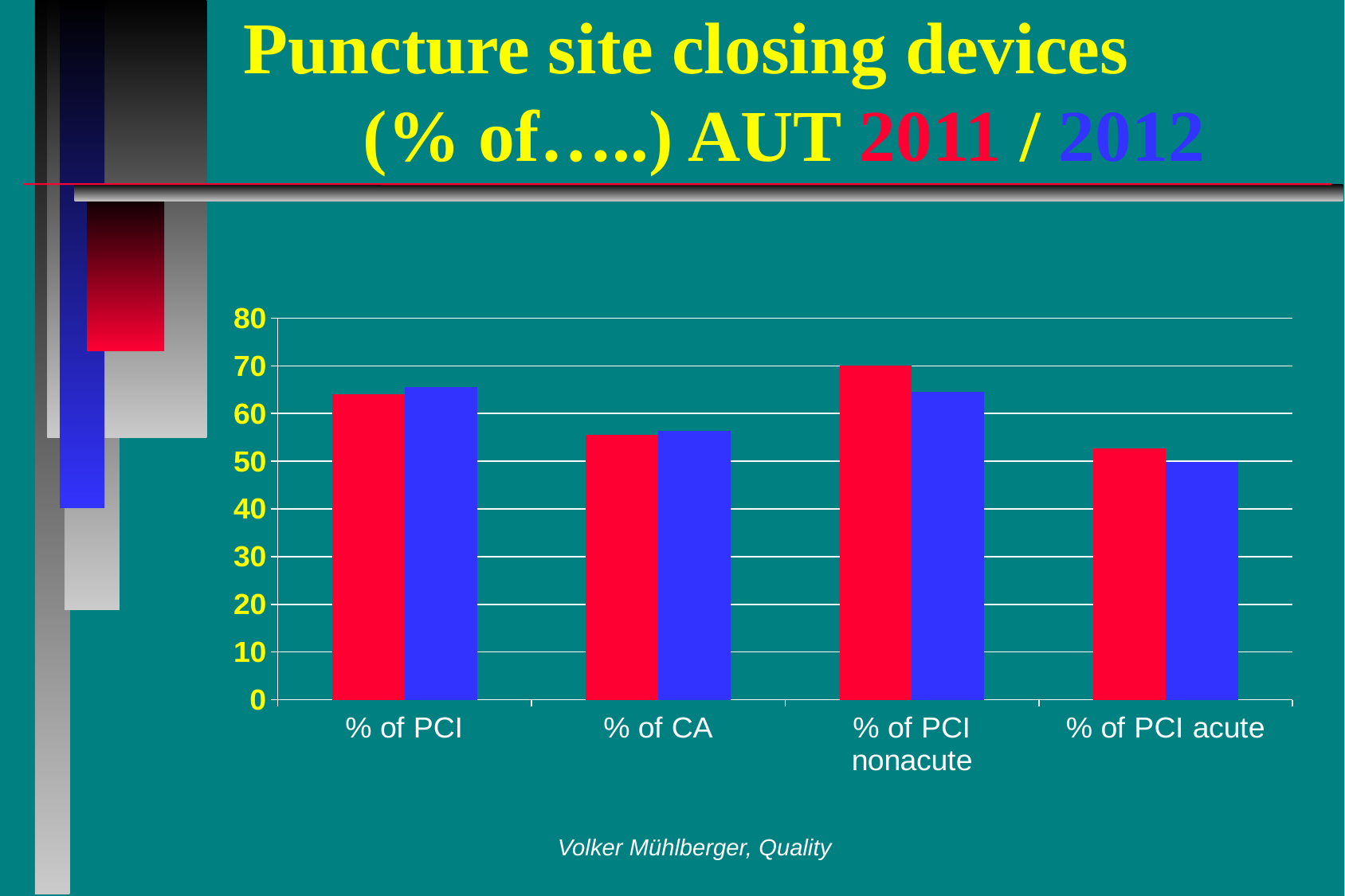
For % of PCI nonacute, which year has the larger value, 2011 or 2012? 2011 How many categories are shown on the x axis of the chart? 4 Which category has the lowest blue (2012) bar? % of PCI acute Is the 2012 value for % of PCI nonacute greater or less than 60? greater What kind of chart is shown on the slide? bar chart What colour are the bars representing 2011? red Is the 2011 value for % of CA greater or less than 50? greater What is the title of the slide containing the chart? Puncture site closing devices (% of…..) AUT 2011 / 2012 Which category has the lowest red (2011) bar? % of PCI acute Is the 2011 value for % of PCI greater or less than 60? greater Which category has the highest red (2011) bar? % of PCI nonacute